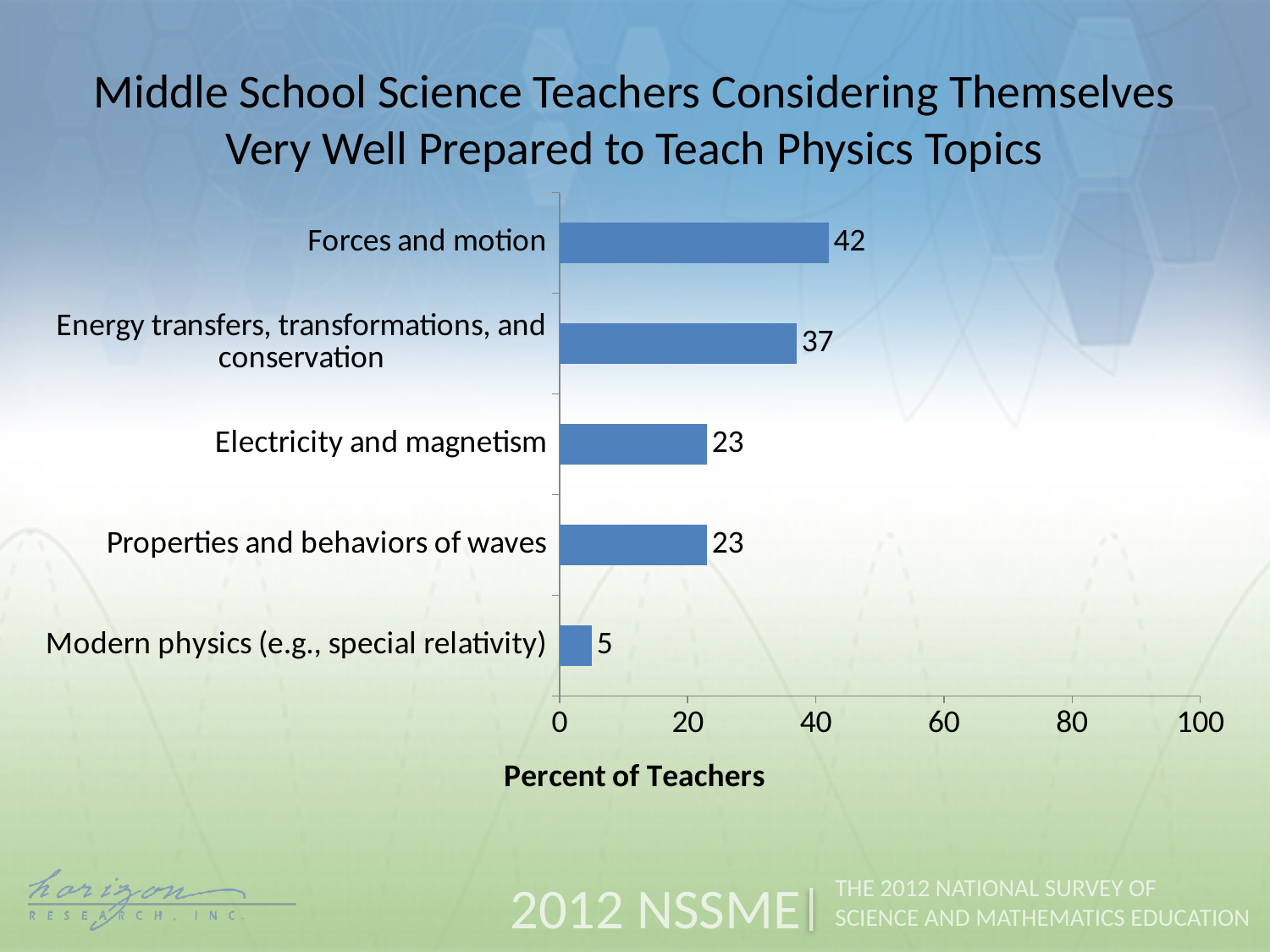
What is the difference between the values for Forces and motion and Energy transfers, transformations, and conservation? 5 What kind of chart is shown on the slide? Bar chart What is the value for Electricity and magnetism? 23 What percent of teachers consider themselves very well prepared to teach Forces and motion? 42 What is the difference between the values for Electricity and magnetism and Modern physics (e.g., special relativity)? 18 Which topic has the highest percent of teachers? Forces and motion Which is larger, the value for Energy transfers, transformations, and conservation or the value for Properties and behaviors of waves? Energy transfers, transformations, and conservation What is the value for Energy transfers, transformations, and conservation? 37 Which topic has the lowest percent of teachers? Modern physics (e.g., special relativity) How many topics are shown in the chart? 5 What is the label of the horizontal axis? Percent of Teachers What is the value for Modern physics (e.g., special relativity)? 5